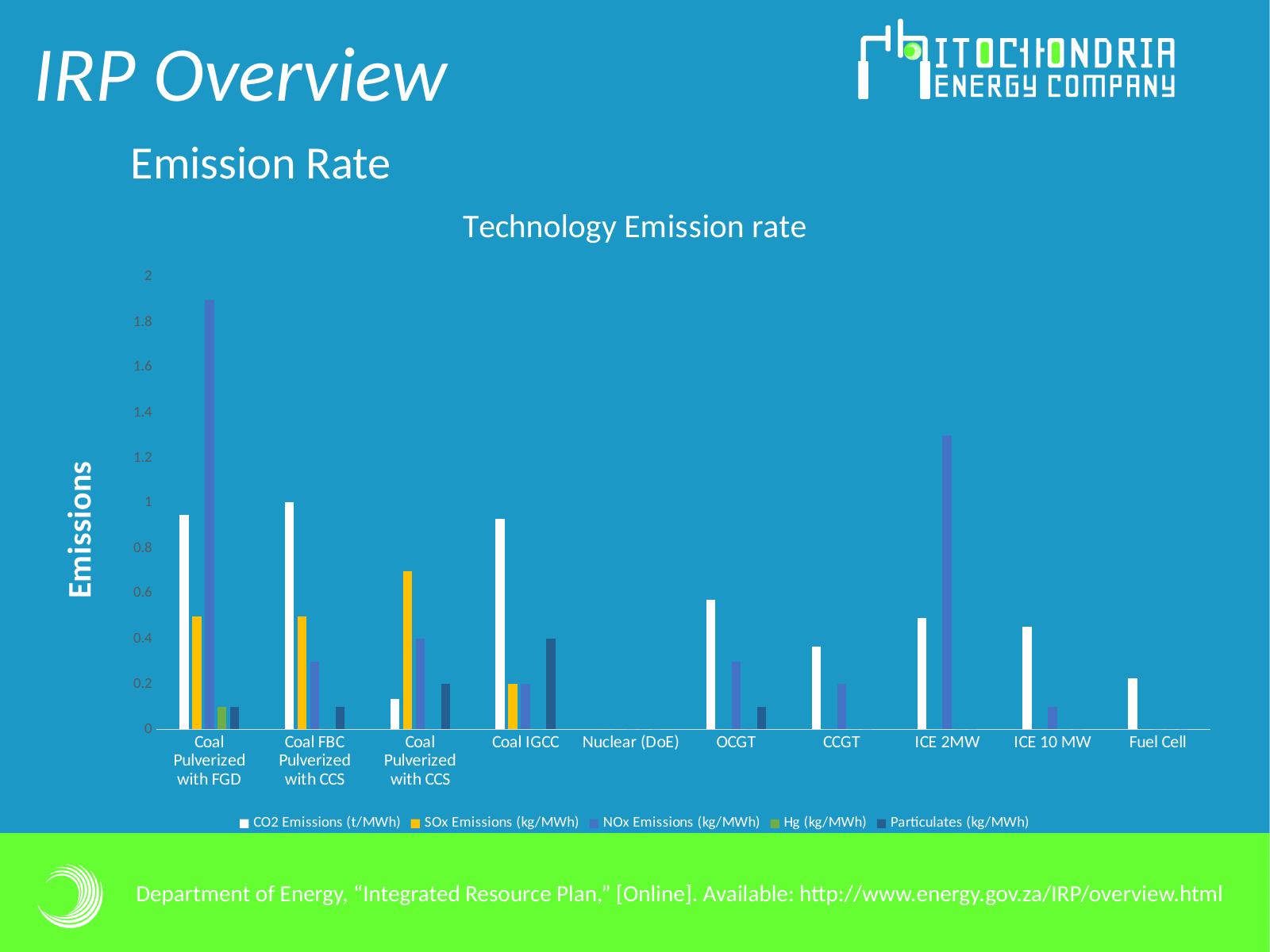
Which has the larger CO2 Emissions (t/MWh) value, Coal FBC Pulverized with CCS or Coal Pulverized with CCS? Coal FBC Pulverized with CCS Which technology has the highest NOx Emissions (kg/MWh) in the Technology Emission rate chart? Coal Pulverized with FGD Which has the larger CO2 Emissions (t/MWh) value, OCGT or CCGT? OCGT What is the title of the chart on the slide? Technology Emission rate Is the CO2 Emissions (t/MWh) value for Fuel Cell greater or less than 0.4? less How many technology categories are shown on the x axis of the Technology Emission rate chart? 10 What is the label on the vertical axis of the Technology Emission rate chart? Emissions Is the NOx Emissions (kg/MWh) value for ICE 2MW greater or less than 1.2? greater Is the NOx Emissions (kg/MWh) value for Coal Pulverized with FGD greater or less than 1.8? greater Which technology has the highest SOx Emissions (kg/MWh) in the Technology Emission rate chart? Coal Pulverized with CCS What kind of chart is the Technology Emission rate chart? bar chart How many series does the legend of the Technology Emission rate chart list? 5